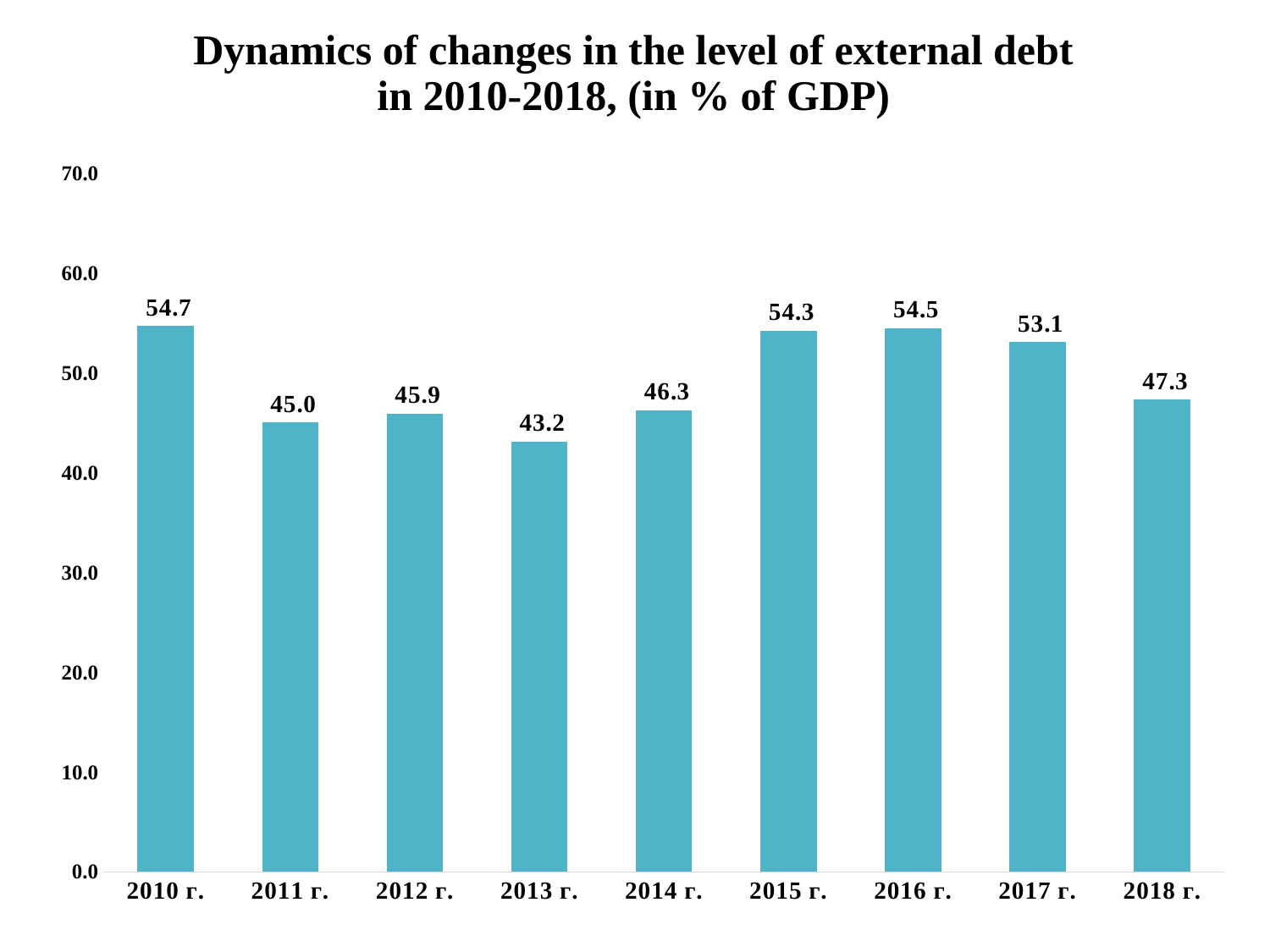
What kind of chart is this? bar chart What is the value for 2018 г.? 47.3 What is the difference between the values for 2010 г. and 2011 г.? 9.7 What is the value for 2013 г.? 43.2 What is the title of the chart? Dynamics of changes in the level of external debt in 2010-2018, (in % of GDP) Which year has the lowest value? 2013 г. Which is larger, the value for 2012 г. or the value for 2014 г.? 2014 г. Is the value for 2015 г. greater or less than 50.0? greater What is the value for 2016 г.? 54.5 What is the difference between the values for 2017 г. and 2018 г.? 5.8 How many years are shown on the x axis? 9 Which year has the highest value? 2010 г.